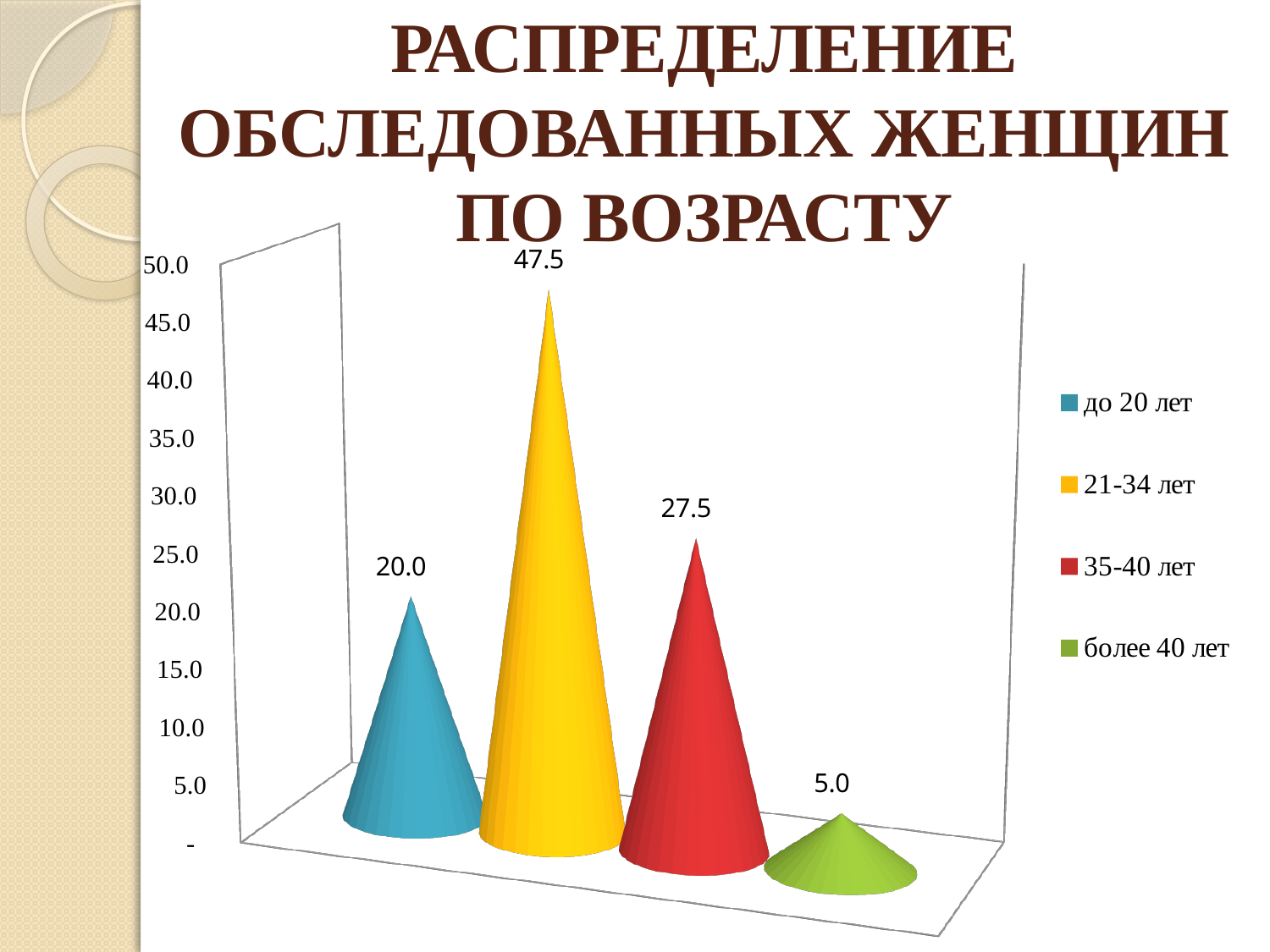
Which age group has the lowest value? более 40 лет Which is larger, the value for до 20 лет or the value for 35-40 лет? 35-40 лет What is the value for the 35-40 лет group? 27.5 What kind of chart is shown on the slide? bar chart Which age group has the highest value? 21-34 лет What is the value for the более 40 лет group? 5.0 How many entries does the legend list? 4 What is the value for the 21-34 лет group? 47.5 What colour is the bar for the 35-40 лет group? red How many age groups are shown in the chart? 4 What is the value for the до 20 лет group? 20.0 What is the difference between the values for 21-34 лет and 35-40 лет? 20.0